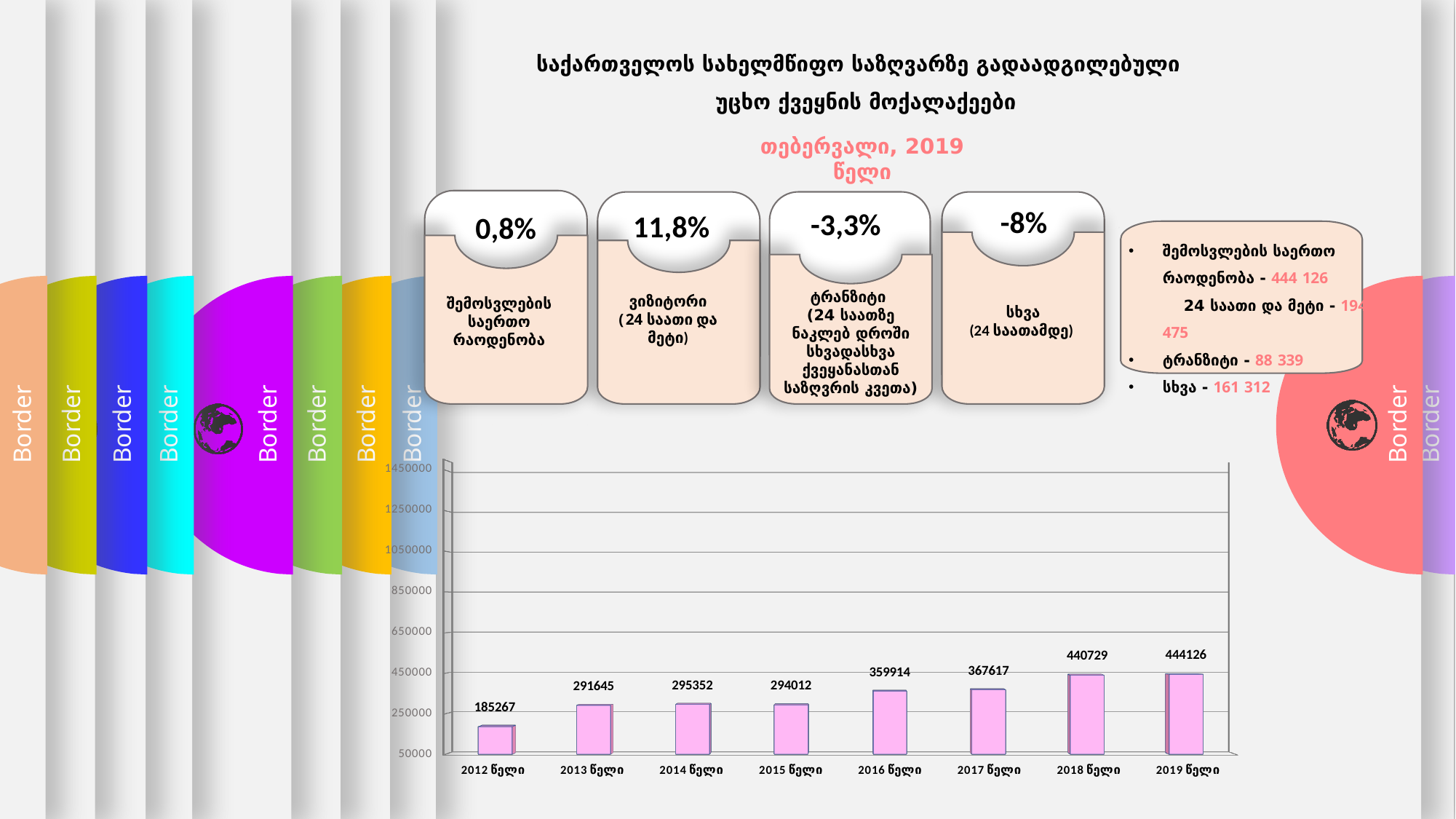
Which is larger, the value for 2014 წელი or the value for 2015 წელი? 2014 წელი How many years are shown on the x axis of the bar chart? 8 Which year has the highest value in the bar chart? 2019 წელი Do the values in the bar chart generally rise or fall from 2012 წელი to 2019 წელი? rise Is the value for 2017 წელი greater or less than 450000? less Which year has the lowest value in the bar chart? 2012 წელი What is the difference between the values for 2013 წელი and 2012 წელი? 106378 What is the difference between the values for 2019 წელი and 2018 წელი? 3397 What is the value for 2019 წელი in the bar chart? 444126 What kind of chart is shown at the bottom of the slide? bar chart What is the value for 2012 წელი in the bar chart? 185267 What is the value for 2016 წელი in the bar chart? 359914